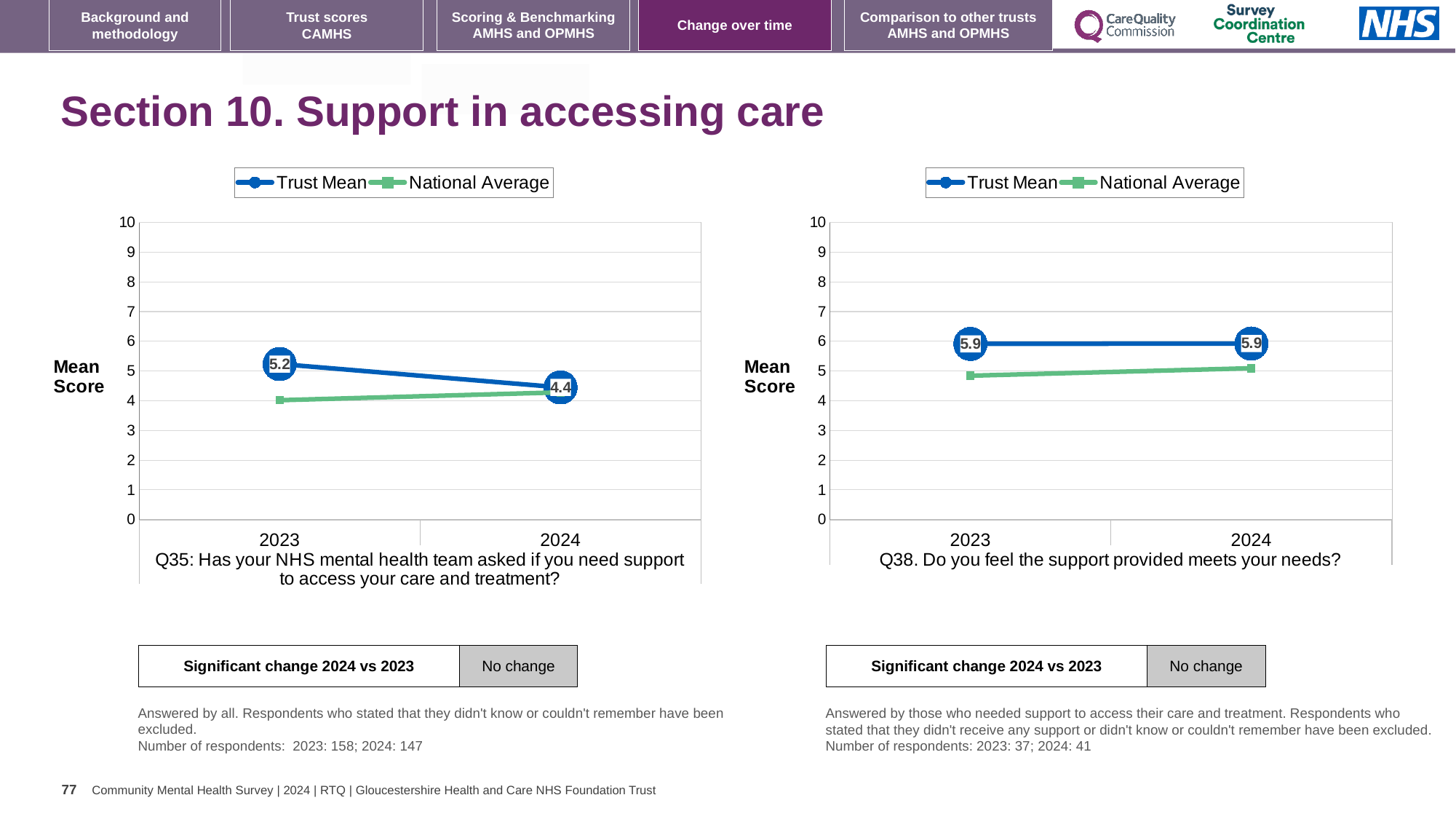
In the Q35 chart on the left, by how much did the Trust Mean change from 2023 to 2024? 0.8 How many years are plotted on the x axis of the Q35 chart on the left? 2 In the Q35 chart on the left, what is the Trust Mean score for 2024? 4.4 In the Q35 chart on the left, does the Trust Mean rise or fall from 2023 to 2024? fall In the Q38 chart on the right, what is the Trust Mean score for 2024? 5.9 In the Q38 chart on the right, is the National Average for 2024 greater or less than 6? less In the Q35 chart on the left, what is the Trust Mean score for 2023? 5.2 In the Q38 chart on the right, does the National Average rise or fall from 2023 to 2024? rise What type of chart is the Q38 chart on the right? line chart How many series does the legend of the Q35 chart on the left list? 2 In the Q35 chart on the left, is the National Average for 2023 greater or less than 5? less In the Q38 chart on the right, which series is higher in 2023, Trust Mean or National Average? Trust Mean